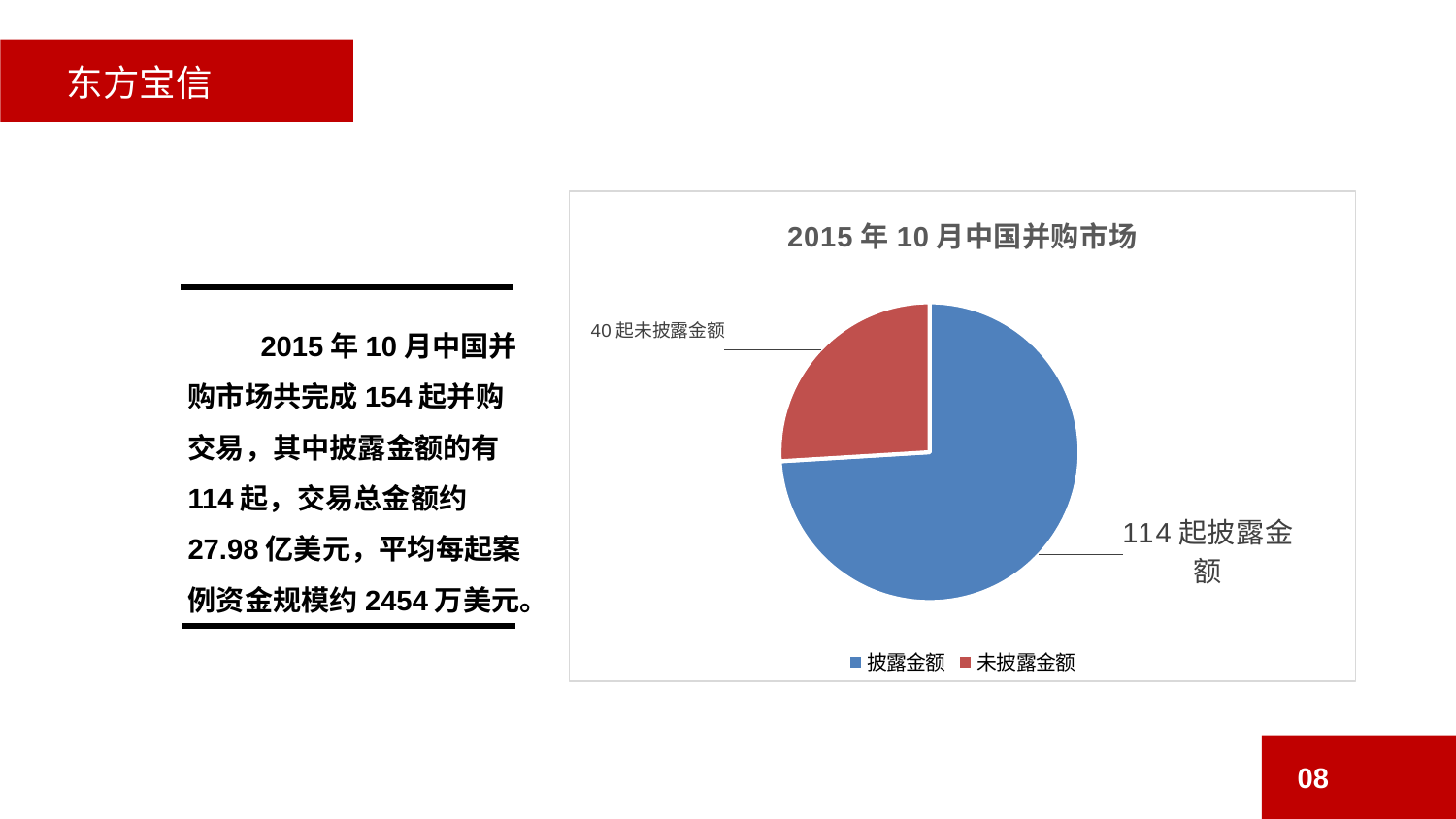
How many deals are in the 披露金额 slice? 114起 What is the difference between the number of 披露金额 deals and 未披露金额 deals? 74起 How many slices does the pie chart have? 2 What is the title of the chart? 2015年10月中国并购市场 What is the total number of deals represented in the pie chart? 154起 Which slice is the smallest in the pie chart? 未披露金额 How many deals are in the 未披露金额 slice? 40起 Which colour represents 未披露金额 in the pie chart? red What type of chart is shown on the slide? pie chart How many entries does the chart legend list? 2 Which slice is the largest in the pie chart? 披露金额 Which is larger, 披露金额 or 未披露金额? 披露金额